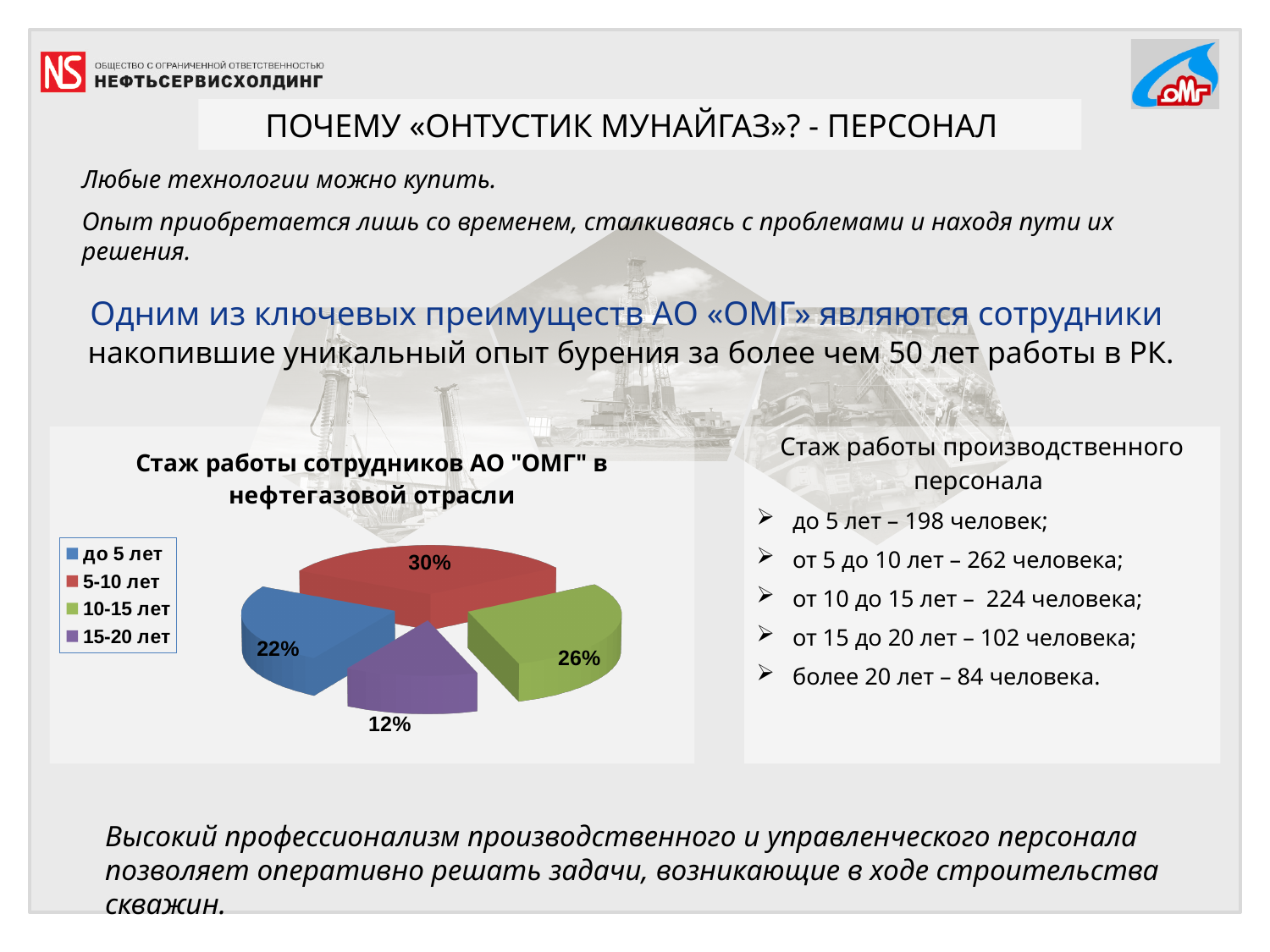
What share of the pie does the "15-20 лет" slice have? 12% How many categories does the legend of the pie chart list? 4 Which category has the smallest slice of the pie? 15-20 лет What is the difference in percentage points between the "5-10 лет" slice and the "15-20 лет" slice? 18% What kind of chart is shown on the slide? pie chart Which slice is larger, "до 5 лет" or "10-15 лет"? 10-15 лет What percentage of the pie is labelled for the "до 5 лет" slice? 22% Which category has the largest slice of the pie? 5-10 лет What percentage is shown for the "5-10 лет" slice? 30% What percentage is shown for the "10-15 лет" slice? 26% What colour is the "5-10 лет" slice in the pie chart? red What is the title of the pie chart? Стаж работы сотрудников АО "ОМГ" в нефтегазовой отрасли